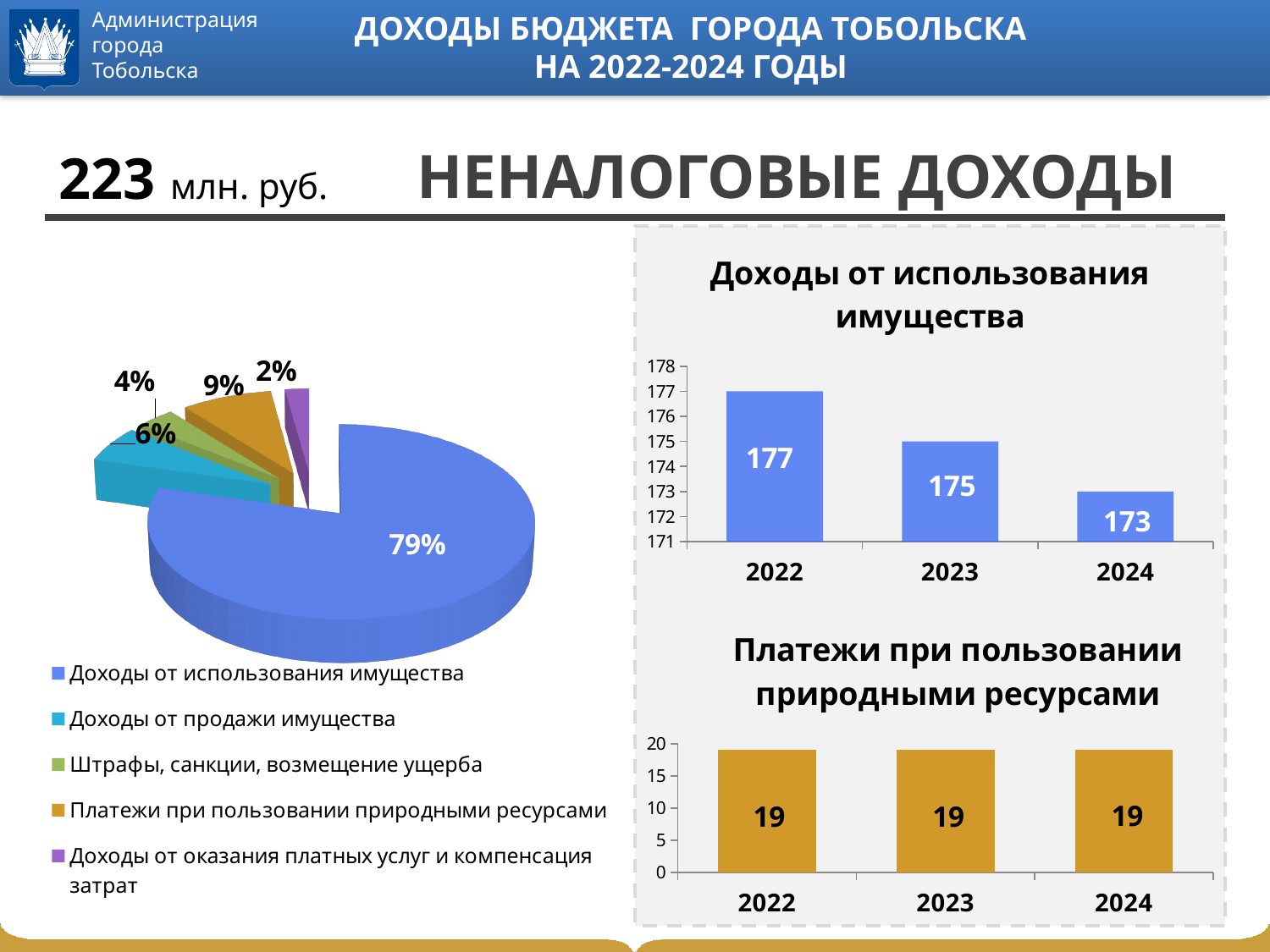
In the chart titled 'Доходы от использования имущества', what is the value for 2022? 177 In the chart titled 'Доходы от использования имущества', which year has the highest value? 2022 In the chart titled 'Платежи при пользовании природными ресурсами', what is the value for 2023? 19 In the pie chart on the left, what share does 'Платежи при пользовании природными ресурсами' have? 9% In the pie chart on the left, which category has the smallest share? Доходы от оказания платных услуг и компенсация затрат In the chart titled 'Доходы от использования имущества', do the values rise or fall from 2022 to 2024? fall In the pie chart on the left, how many categories does the legend list? 5 In the chart titled 'Платежи при пользовании природными ресурсами', how many years are shown? 3 In the chart titled 'Доходы от использования имущества', what is the value for 2024? 173 In the chart titled 'Доходы от использования имущества', what is the difference between the 2022 and 2024 values? 4 In the chart titled 'Платежи при пользовании природными ресурсами', what kind of chart is it? bar chart In the pie chart on the left, what share does 'Доходы от использования имущества' have? 79%